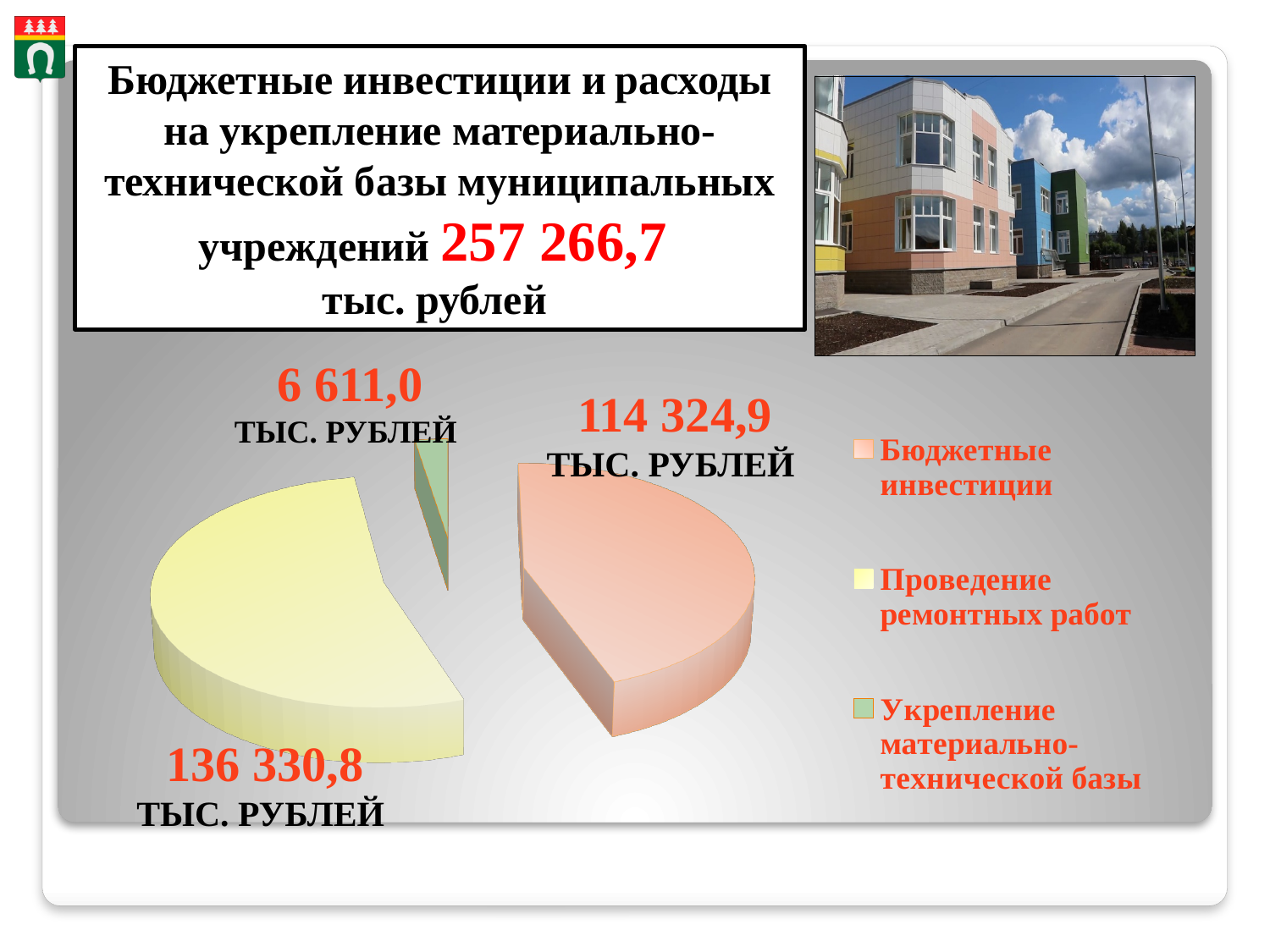
What is the value for Бюджетные инвестиции? 114 324,9 тыс. рублей Which category has the smallest slice of the pie? Укрепление материально-технической базы What is the value for Проведение ремонтных работ? 136 330,8 тыс. рублей Which category has the largest slice of the pie? Проведение ремонтных работ What colour is the slice for Проведение ремонтных работ? Yellow What is the difference between Проведение ремонтных работ and Бюджетные инвестиции? 22 005,9 тыс. рублей Which is larger: Бюджетные инвестиции or Проведение ремонтных работ? Проведение ремонтных работ What is the total of all three slices of the pie? 257 266,7 тыс. рублей How many slices does the pie chart have? 3 How many entries does the legend list? 3 What kind of chart is shown on the slide? Pie chart What is the value for Укрепление материально-технической базы? 6 611,0 тыс. рублей